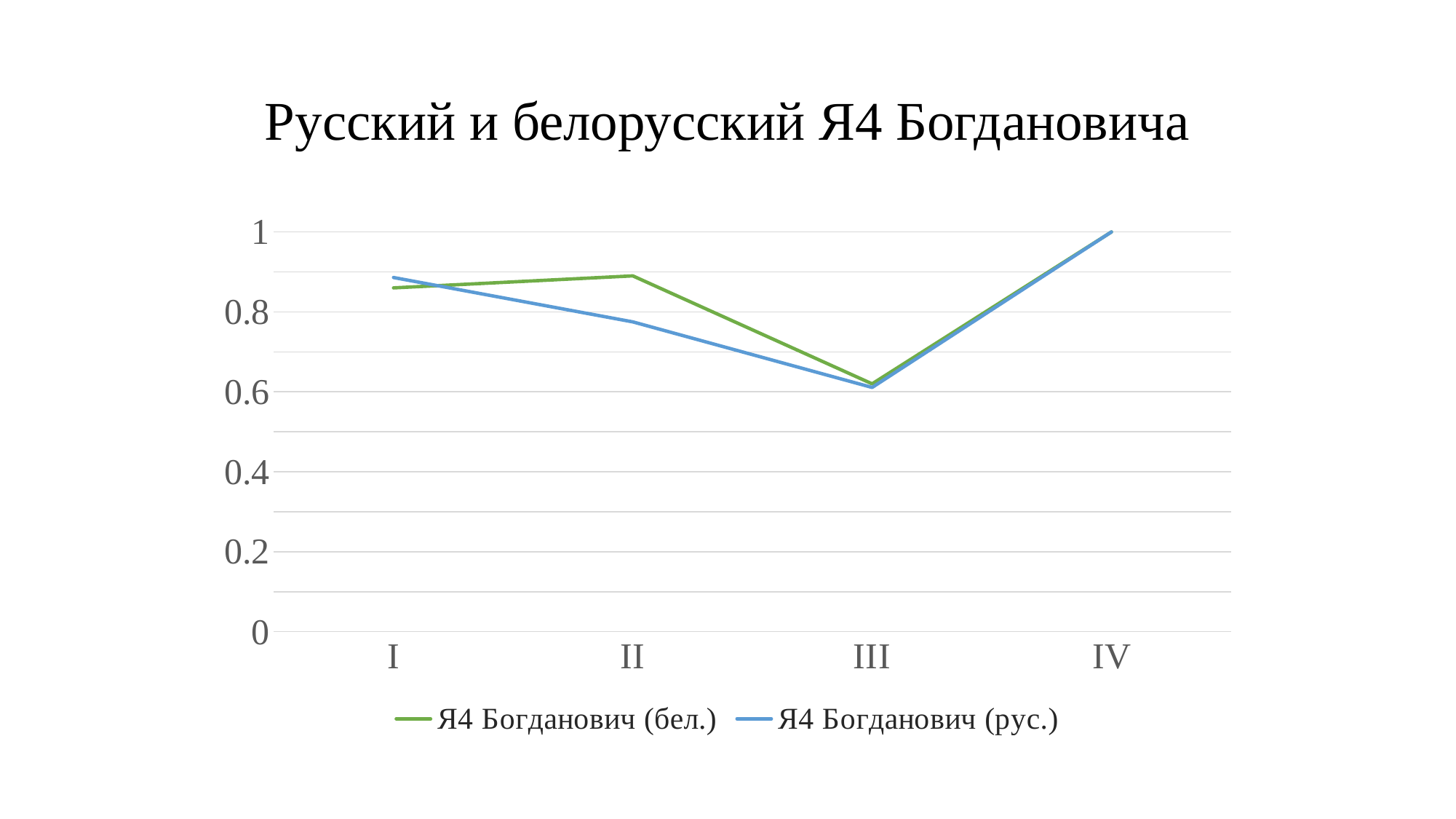
What is the value for Я4 Богданович (рус.) at IV? 1 What is the title of the chart? Русский и белорусский Я4 Богдановича What kind of chart is shown on the slide? line chart Is the value for Я4 Богданович (бел.) at II greater or less than 0.8? greater Do the values for Я4 Богданович (рус.) rise or fall from III to IV? rise At which category is Я4 Богданович (бел.) lowest? III At II, which series has the larger value, Я4 Богданович (бел.) or Я4 Богданович (рус.)? Я4 Богданович (бел.) How many series does the legend list? 2 How many categories are on the x axis? 4 At which category is Я4 Богданович (рус.) highest? IV Is the value for Я4 Богданович (рус.) at II greater or less than 0.8? less What is the value for Я4 Богданович (бел.) at IV? 1